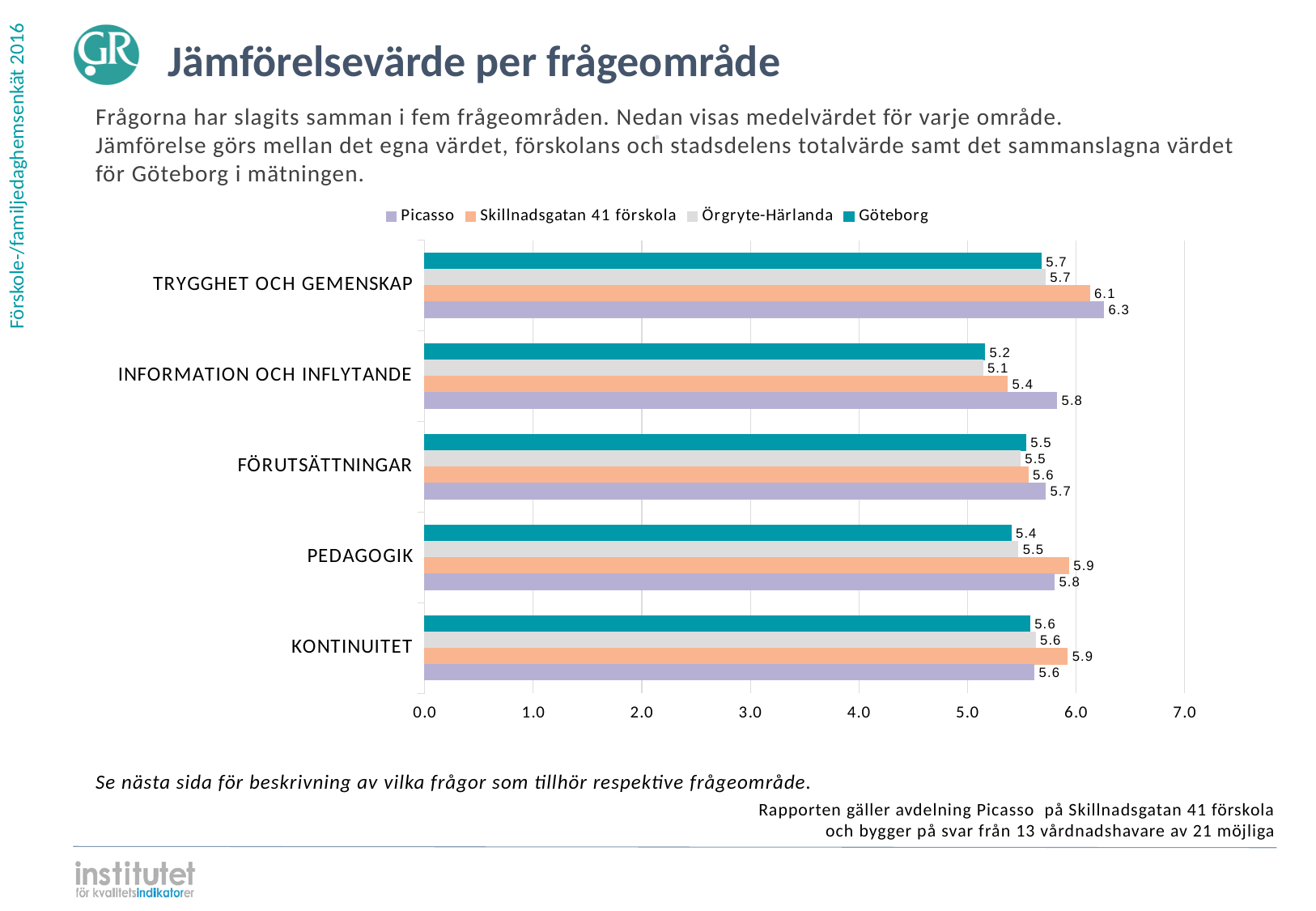
What kind of chart is shown on the slide? Bar chart What is the value for Picasso in the TRYGGHET OCH GEMENSKAP category? 6.3 In the PEDAGOGIK category, which is larger: the value for Skillnadsgatan 41 förskola or the value for Picasso? Skillnadsgatan 41 förskola What is the value for Göteborg in the INFORMATION OCH INFLYTANDE category? 5.2 What is the value for Skillnadsgatan 41 förskola in the PEDAGOGIK category? 5.9 In which category does Göteborg have its lowest value? INFORMATION OCH INFLYTANDE What is the difference between the Picasso value and the Göteborg value in the INFORMATION OCH INFLYTANDE category? 0.6 What is the value for Örgryte-Härlanda in the KONTINUITET category? 5.6 In which category does Picasso have its highest value? TRYGGHET OCH GEMENSKAP Which series is shown in teal in the legend? Göteborg How many question areas (categories) are shown on the chart? 5 How many series does the legend list? 4